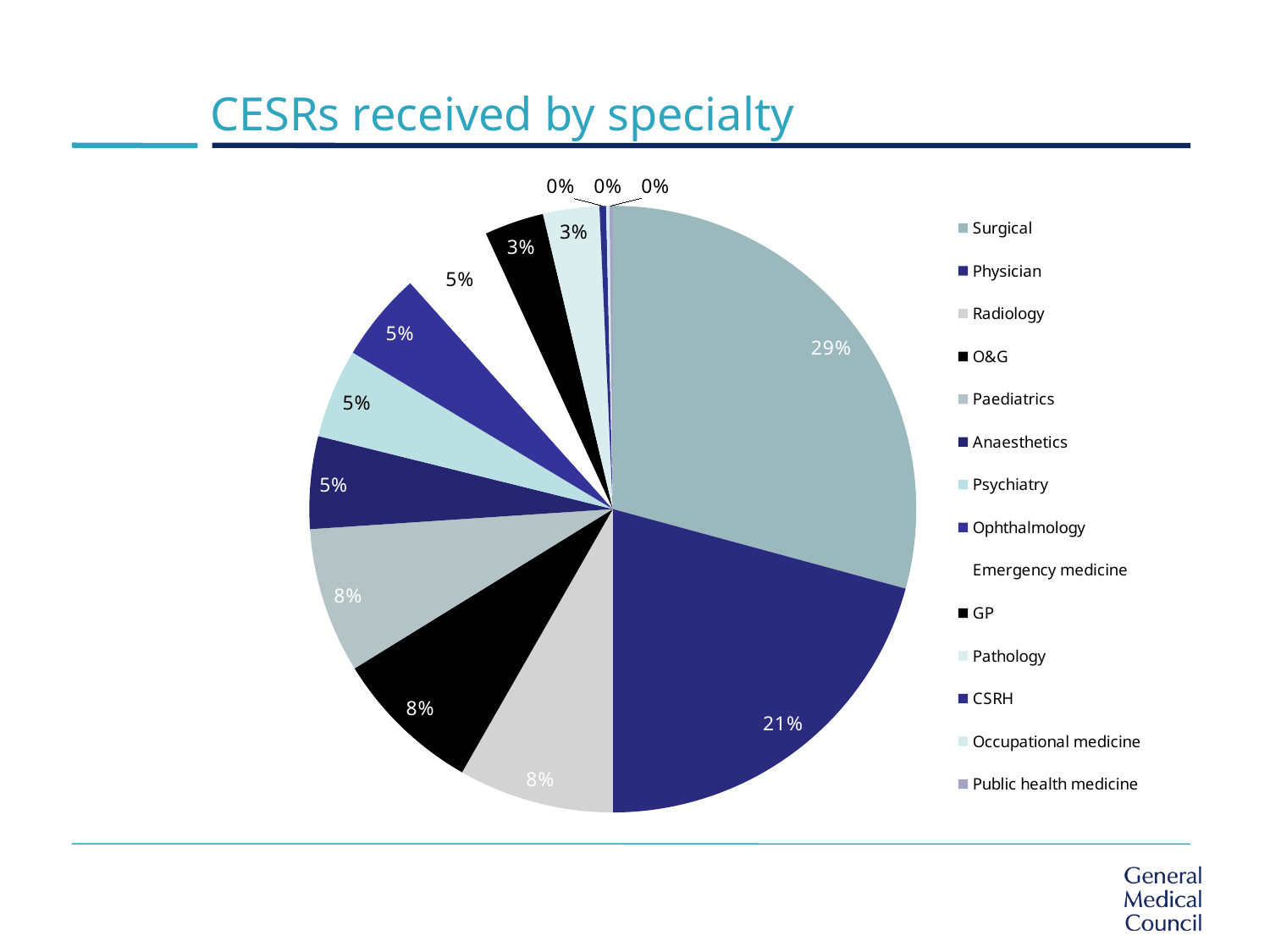
How many specialties does the legend list? 14 What share of CESRs received is for the Physician specialty? 21% What share of CESRs received is for Anaesthetics? 5% Which has the larger share of CESRs received, Physician or Radiology? Physician Which specialty has the largest share of CESRs received? Surgical What share of CESRs received is for GP? 3% What kind of chart is shown on the slide? Pie chart What is the difference in percentage points between the Surgical and Physician shares? 8 What is the title of the chart? CESRs received by specialty